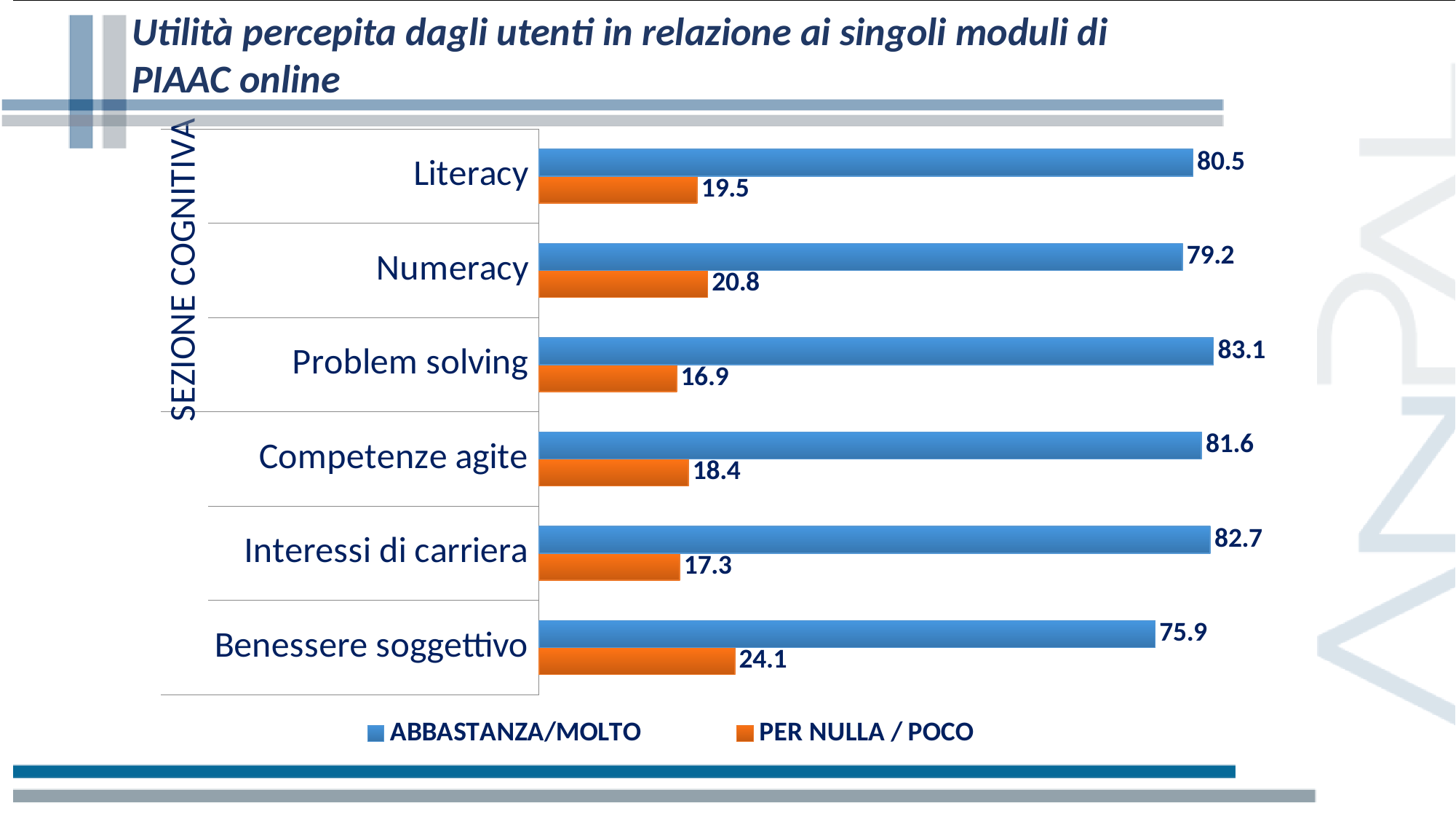
Which category has the lowest ABBASTANZA/MOLTO value? Benessere soggettivo How many series does the legend list? 2 What is the PER NULLA / POCO value for Benessere soggettivo? 24.1 What kind of chart is shown on the slide? Bar chart What colour are the PER NULLA / POCO bars? Orange Which category has the highest ABBASTANZA/MOLTO value? Problem solving What is the ABBASTANZA/MOLTO value for Literacy? 80.5 Which is larger: the ABBASTANZA/MOLTO value for Interessi di carriera or for Competenze agite? Interessi di carriera What is the difference between the ABBASTANZA/MOLTO values for Problem solving and Benessere soggettivo? 7.2 What is the PER NULLA / POCO value for Numeracy? 20.8 Which category has the lowest PER NULLA / POCO value? Problem solving How many categories are shown in the chart? 6